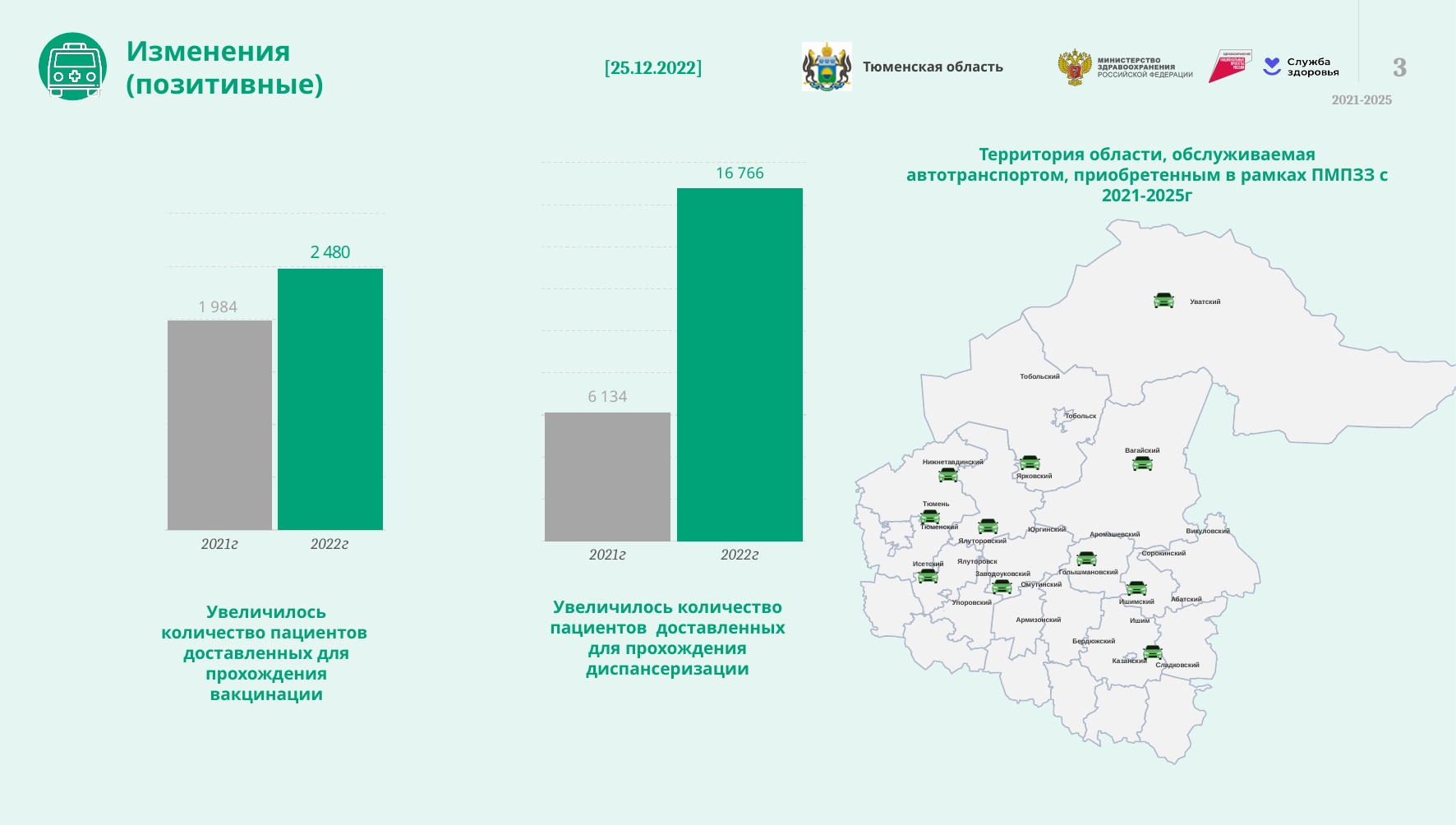
On the middle chart (patients delivered for диспансеризация), what is the value for 2022г? 16 766 On the middle chart (patients delivered for диспансеризация), what is the value for 2021г? 6 134 How many bars does the left chart have? 2 On the left chart (patients delivered for vaccination), what is the value for 2021г? 1 984 On the middle chart, which year has the lower value? 2021г What type of chart is the middle chart? bar chart On the left chart, what is the difference between the 2022г and 2021г values? 496 On the left chart, which year has the higher value? 2022г On the left chart, what colour is the bar for 2022г? green On the left chart (patients delivered for vaccination), what is the value for 2022г? 2 480 On the middle chart, is the value for 2021г larger or smaller than the value for 2022г? smaller On the middle chart, what is the difference between the 2022г and 2021г values? 10 632